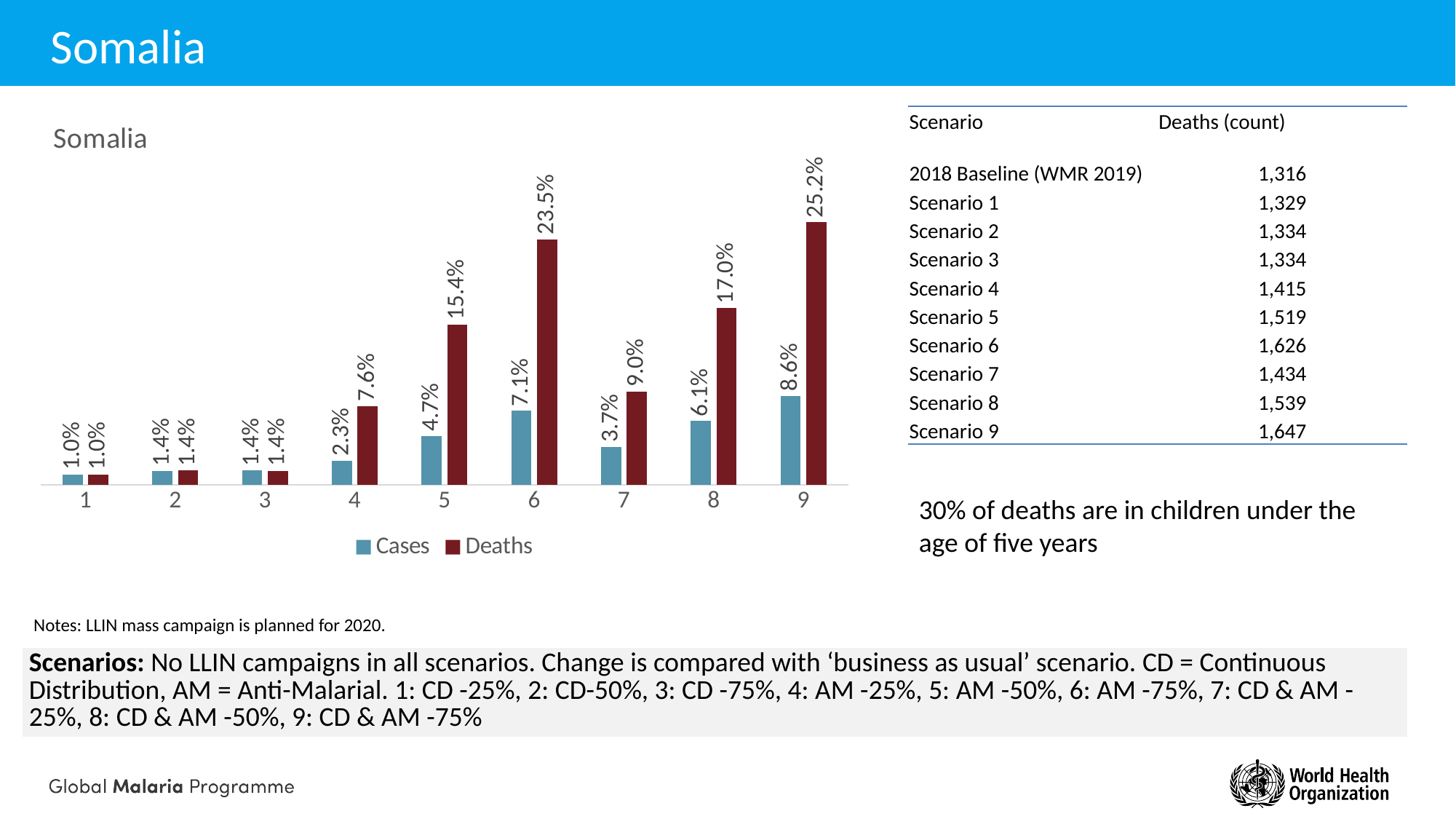
Which scenario has the highest Deaths value? 9 What are the two series named in the chart legend? Cases and Deaths What is the difference between the Deaths value and the Cases value for scenario 8? 10.9% What is the Cases value for scenario 4? 2.3% What is the Deaths value for scenario 6? 23.5% Which scenario has the lowest Cases value? 1 How many scenarios are shown on the x axis of the chart? 9 What is the Cases value for scenario 5? 4.7% What is the Deaths value for scenario 9? 25.2% Which is larger, the Deaths value for scenario 6 or the Deaths value for scenario 8? Scenario 6 How many series does the chart legend list? 2 What kind of chart is shown on the slide? Bar chart